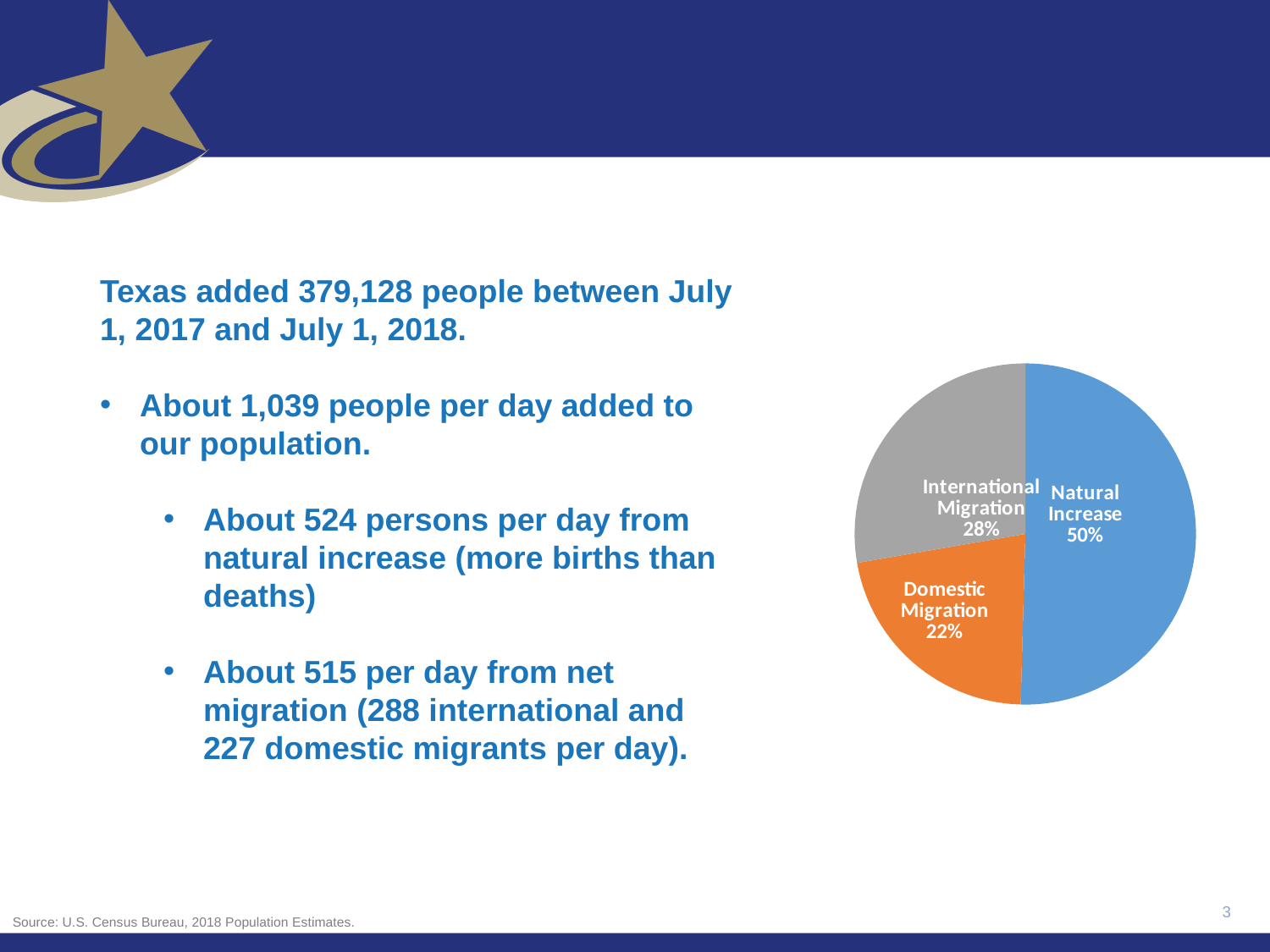
What share of the pie does Domestic Migration account for? 22% Which slice of the pie chart is the smallest? Domestic Migration What colour is the Domestic Migration slice in the pie chart? orange What share of the pie does Natural Increase account for? 50% What share of the pie does International Migration account for? 28% How many slices does the pie chart have? 3 Which slice of the pie chart is the largest? Natural Increase Which is larger in the pie chart, International Migration or Domestic Migration? International Migration What is the difference in percentage points between the International Migration slice and the Domestic Migration slice? 6 What colour is the Natural Increase slice in the pie chart? blue What kind of chart is shown on the slide? pie chart What is the difference in percentage points between the Natural Increase slice and the Domestic Migration slice? 28